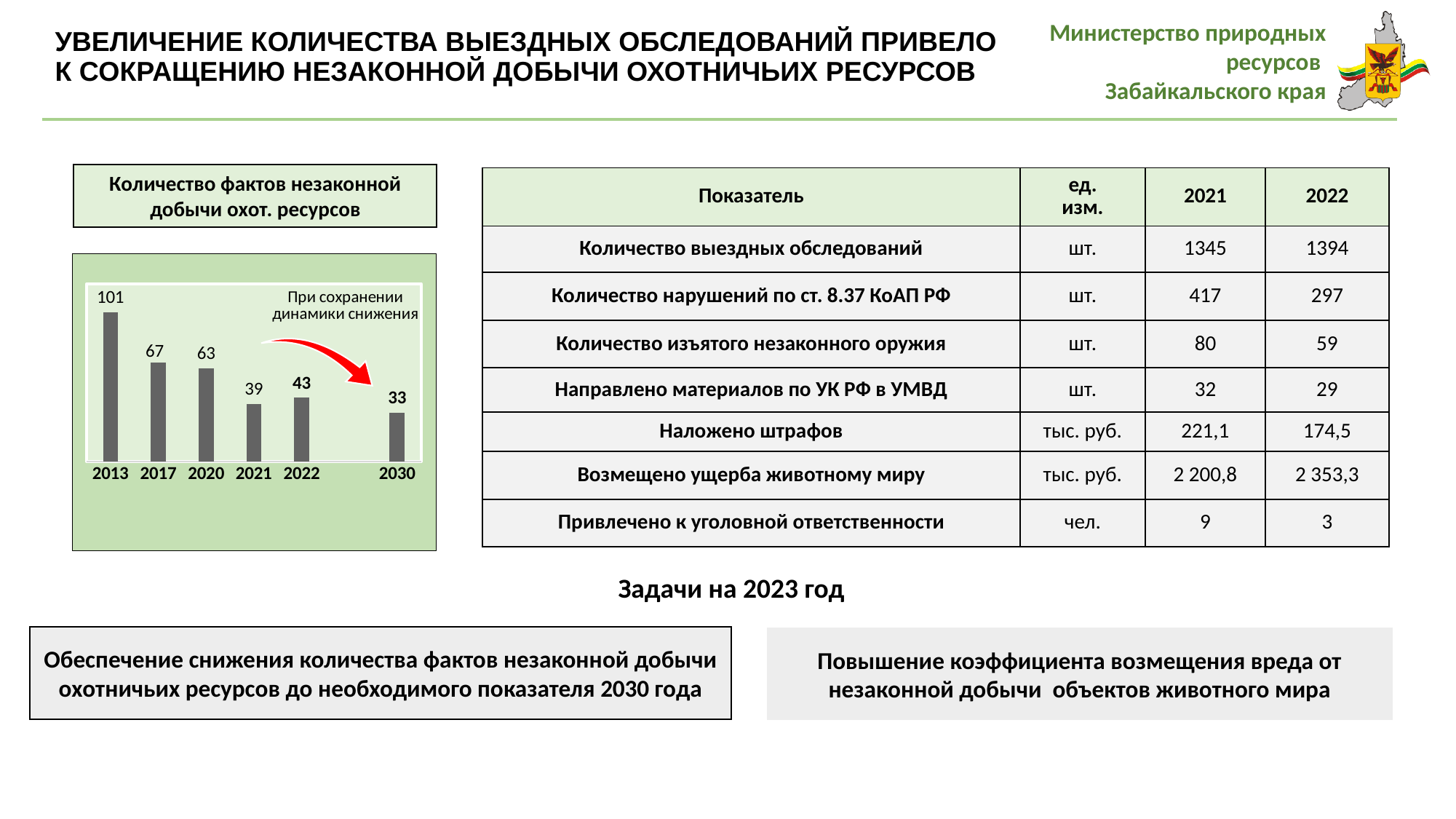
What is the value for 2030 in the chart "Количество фактов незаконной добычи охот. ресурсов"? 33 Which year has the lowest value in the chart "Количество фактов незаконной добычи охот. ресурсов"? 2030 What is the value for 2013 in the chart "Количество фактов незаконной добычи охот. ресурсов"? 101 In the chart "Количество фактов незаконной добычи охот. ресурсов", what is the difference between the values for 2017 and 2020? 4 What type of chart is shown under the title "Количество фактов незаконной добычи охот. ресурсов"? bar chart In the chart "Количество фактов незаконной добычи охот. ресурсов", do the values generally rise or fall from 2013 to 2030? fall Which year has the highest value in the chart "Количество фактов незаконной добычи охот. ресурсов"? 2013 How many years (bars) are shown in the chart "Количество фактов незаконной добычи охот. ресурсов"? 6 In the chart "Количество фактов незаконной добычи охот. ресурсов", what is the difference between the values for 2013 and 2030? 68 In the chart "Количество фактов незаконной добычи охот. ресурсов", which is larger: the value for 2021 or the value for 2022? 2022 What is the value for 2021 in the chart "Количество фактов незаконной добычи охот. ресурсов"? 39 What is the value for 2022 in the chart "Количество фактов незаконной добычи охот. ресурсов"? 43